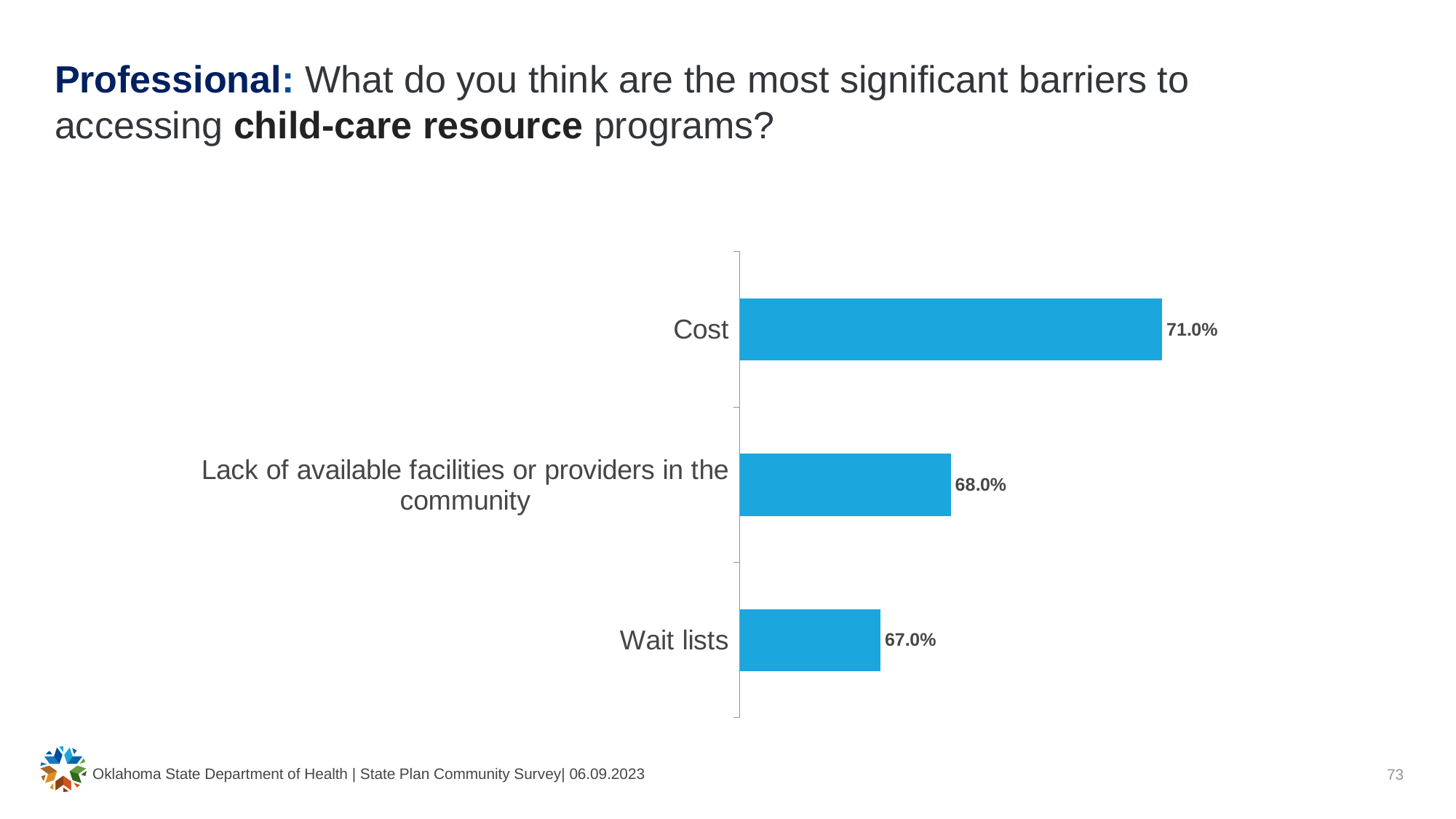
What percentage of professionals cited Cost as a barrier to accessing child-care resource programs? 71.0% Which barrier has the highest percentage? Cost Which barrier has the lowest percentage? Wait lists What is the value shown for Lack of available facilities or providers in the community? 68.0% Which category is listed at the top of the chart? Cost What is the value shown for Wait lists? 67.0% How many barrier categories are shown in the chart? 3 What is the difference between Cost and Lack of available facilities or providers in the community? 3.0% What is the difference in percentage points between Cost and Wait lists? 4.0% What kind of chart is shown on the slide? Bar chart Which is larger: the value for Lack of available facilities or providers in the community or the value for Wait lists? Lack of available facilities or providers in the community What colour are the bars in the chart? Blue